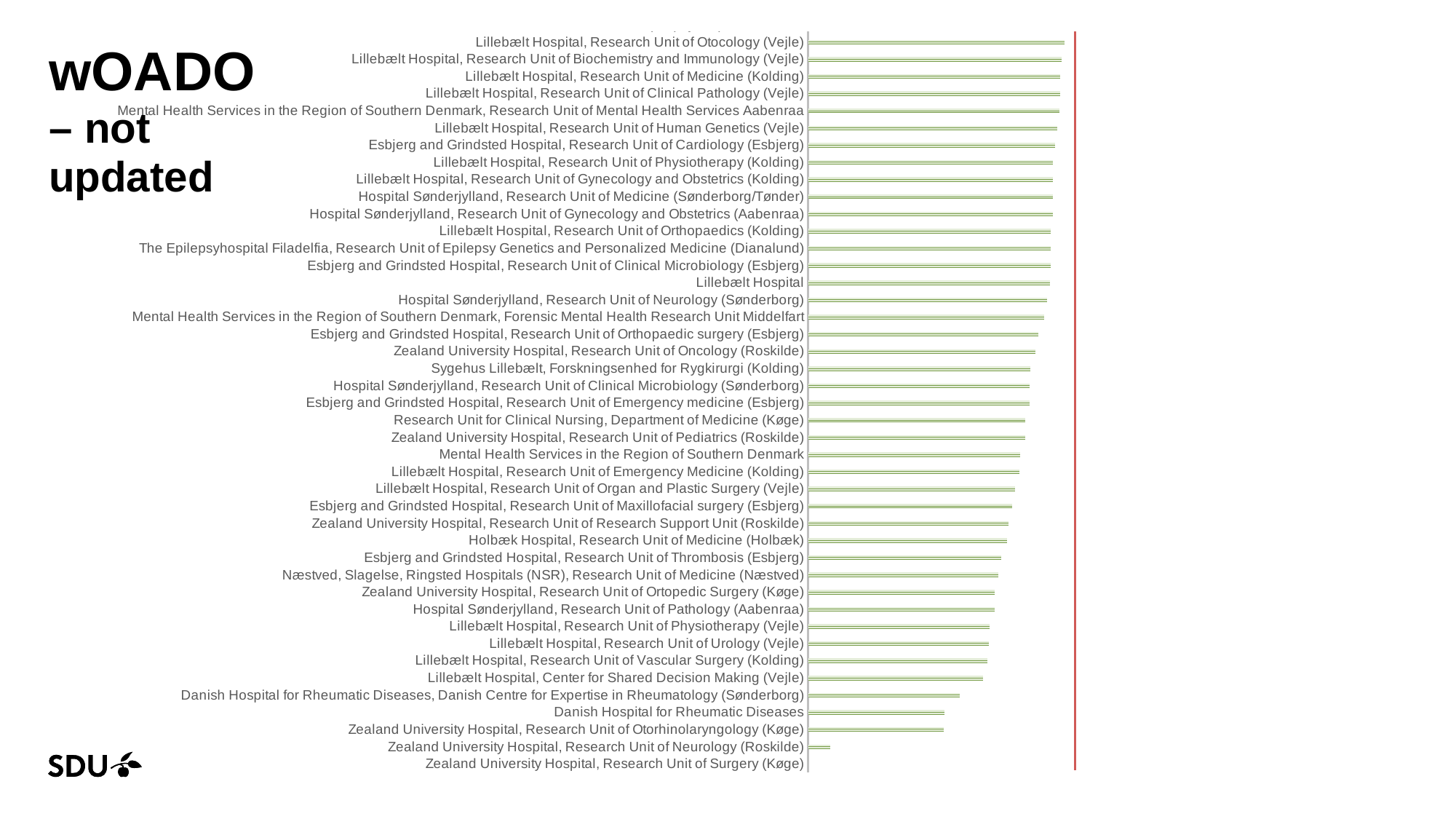
What colour are the bars in the chart? green What is the title shown on the slide? wOADO – not updated Which has the larger value: Zealand University Hospital, Research Unit of Otorhinolaryngology (Køge) or Esbjerg and Grindsted Hospital, Research Unit of Cardiology (Esbjerg)? Esbjerg and Grindsted Hospital, Research Unit of Cardiology (Esbjerg) Which category has the lowest value in the chart? Zealand University Hospital, Research Unit of Surgery (Køge) Which has the larger value: Lillebælt Hospital or Danish Hospital for Rheumatic Diseases? Lillebælt Hospital Which has the larger value: Lillebælt Hospital, Research Unit of Otocology (Vejle) or Zealand University Hospital, Research Unit of Neurology (Roskilde)? Lillebælt Hospital, Research Unit of Otocology (Vejle) What kind of chart is shown on the slide? bar chart Do the bar lengths increase or decrease going from the top of the chart to the bottom? decrease